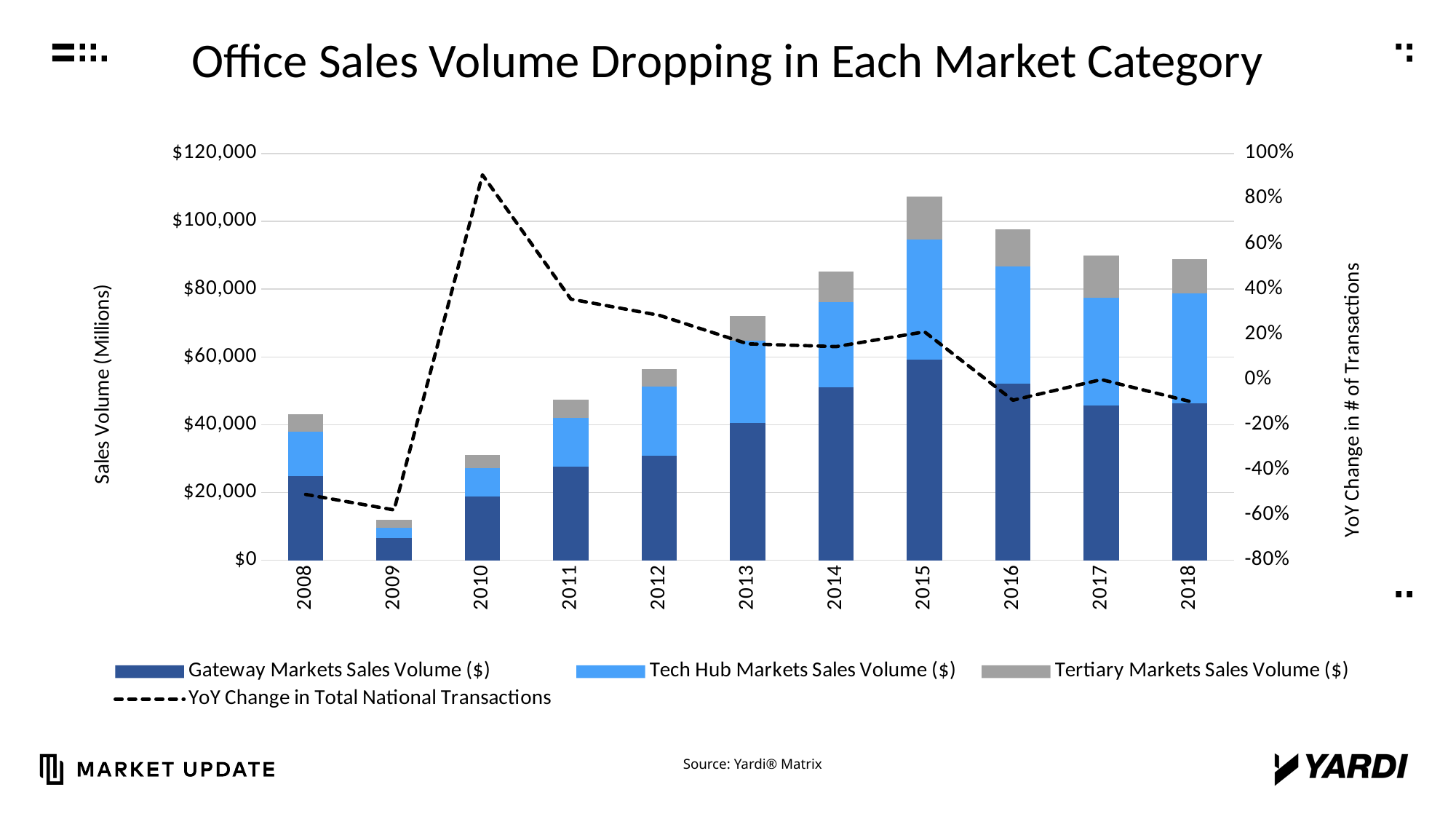
Which year has the larger total sales volume, 2013 or 2014? 2014 Is the total sales volume for 2015 greater or less than $100,000? greater How many series does the legend list? 4 Does the total sales volume rise or fall from 2015 to 2018? fall Is the YoY Change in Total National Transactions for 2010 greater or less than 80%? greater What kind of chart is shown on the slide? combination bar and line chart (stacked bars with a dashed line) Which year has the highest total sales volume (tallest stacked bar)? 2015 In which year does the YoY Change in Total National Transactions line reach its lowest point? 2009 How many years are shown along the x axis? 11 Which year has the lowest total sales volume (shortest stacked bar)? 2009 Is the total sales volume for 2009 greater or less than $20,000? less In which year does the YoY Change in Total National Transactions line reach its highest point? 2010